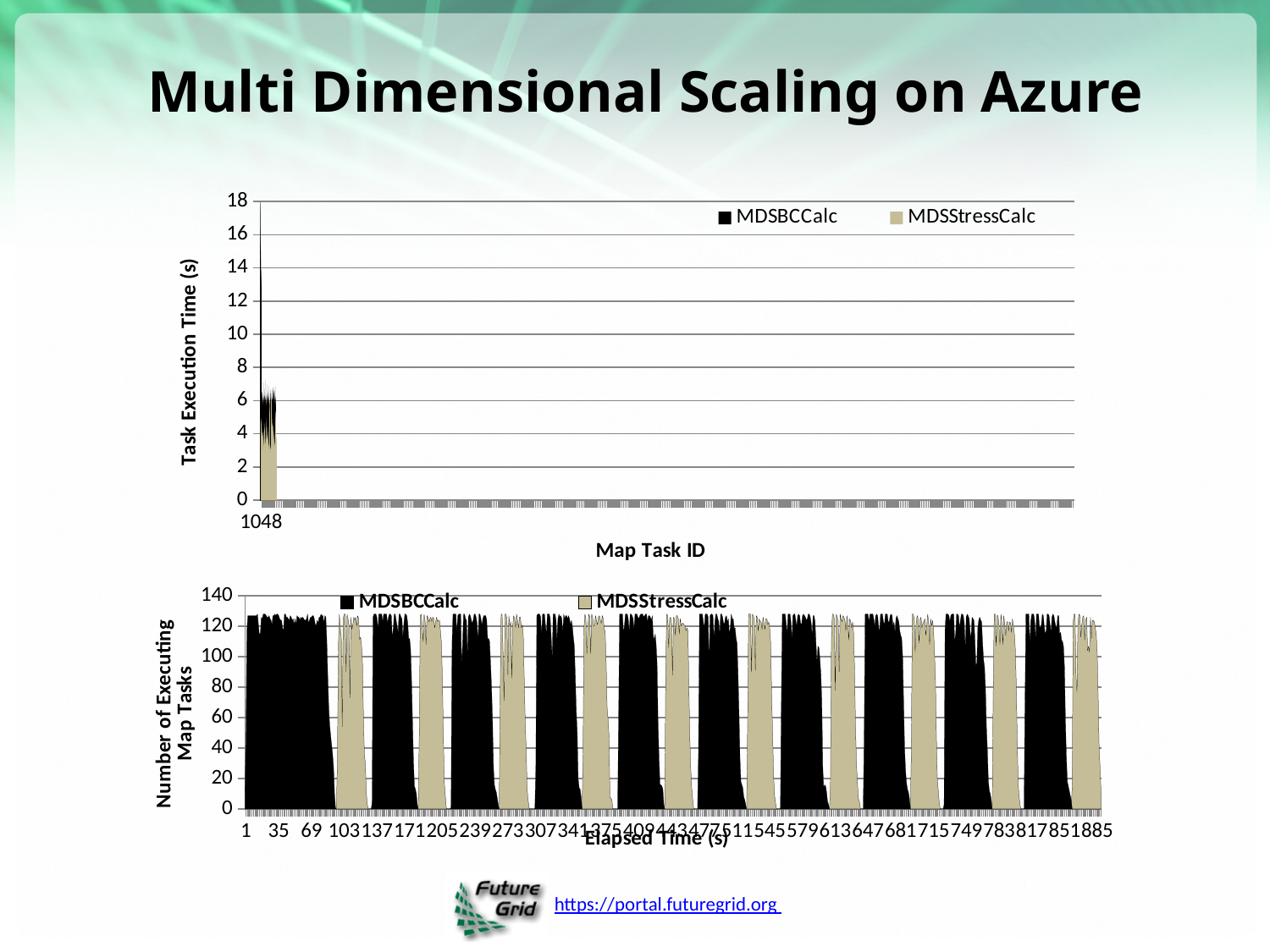
In the top chart (Task Execution Time vs Map Task ID), how many series does the legend list? 2 What is the y-axis title of the top chart? Task Execution Time (s) What is the x-axis title of the bottom chart? Elapsed Time (s) What kind of chart is the bottom chart on the slide? Bar chart In the bottom chart (Number of Executing Map Tasks vs Elapsed Time), how many series does the legend list? 2 In the bottom chart, is the peak number of executing map tasks greater or less than 100? greater In the bottom chart, is the peak number of executing map tasks greater or less than 140? less In the top chart, is the highest task execution time shown greater or less than 2? greater